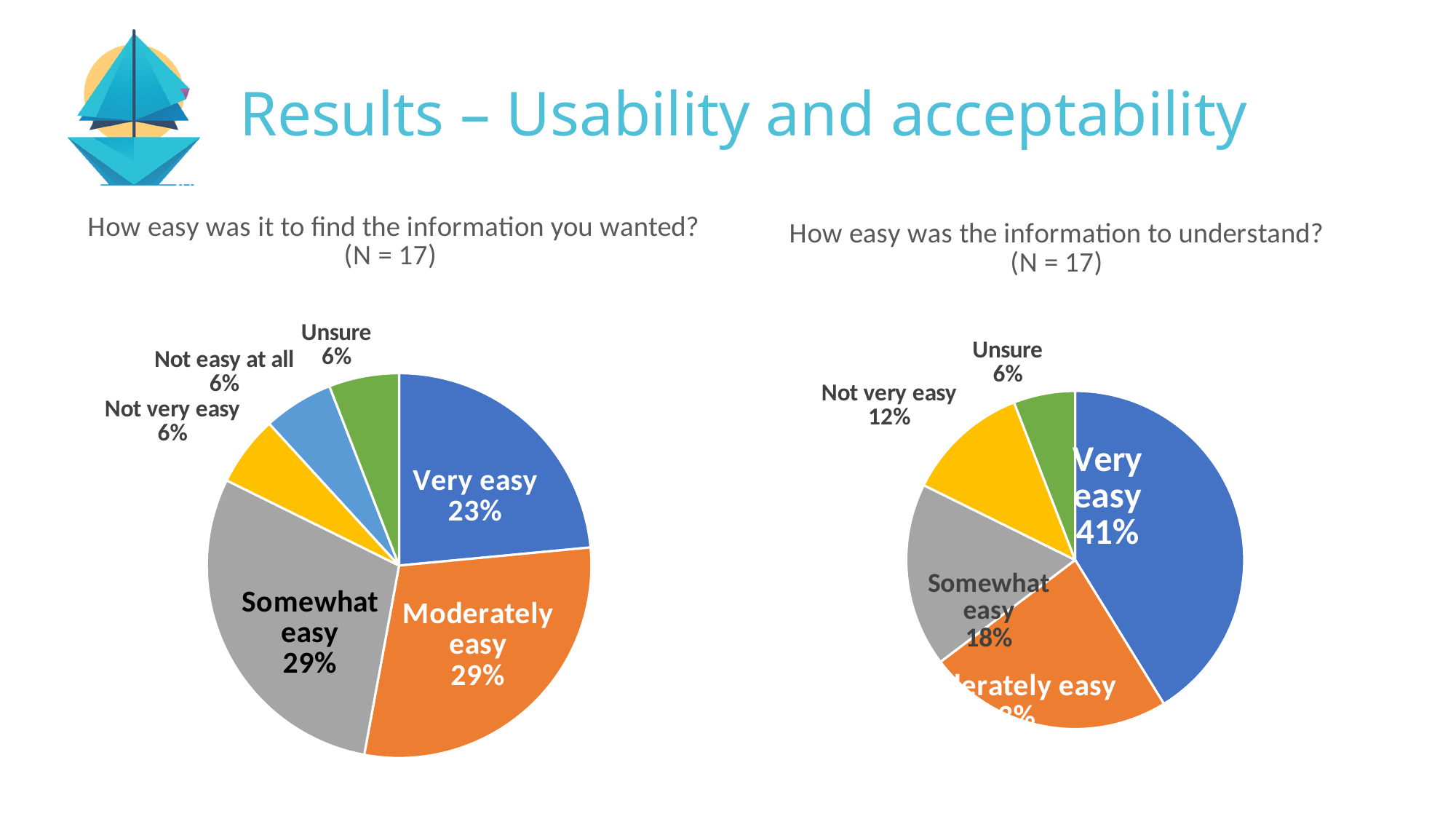
In the chart 'How easy was it to find the information you wanted?', what share of respondents answered 'Somewhat easy'? 29% In the chart 'How easy was it to find the information you wanted?', what share of respondents answered 'Not easy at all'? 6% In the chart 'How easy was the information to understand?', how many slices does the pie have? 5 In the chart 'How easy was the information to understand?', what share of respondents answered 'Not very easy'? 12% In the chart 'How easy was the information to understand?', which response has the largest slice? Very easy In the chart 'How easy was it to find the information you wanted?', how many percentage points larger is 'Moderately easy' than 'Very easy'? 6 percentage points In the chart 'How easy was the information to understand?', which response has the smallest slice? Unsure In the chart 'How easy was it to find the information you wanted?', what share of respondents answered 'Very easy'? 23% In the chart 'How easy was it to find the information you wanted?', which is larger: the 'Moderately easy' slice or the 'Very easy' slice? Moderately easy In the chart 'How easy was it to find the information you wanted?', how many slices does the pie have? 6 What type of chart is used for 'How easy was the information to understand?'? Pie chart In the chart 'How easy was the information to understand?', what share of respondents answered 'Very easy'? 41%